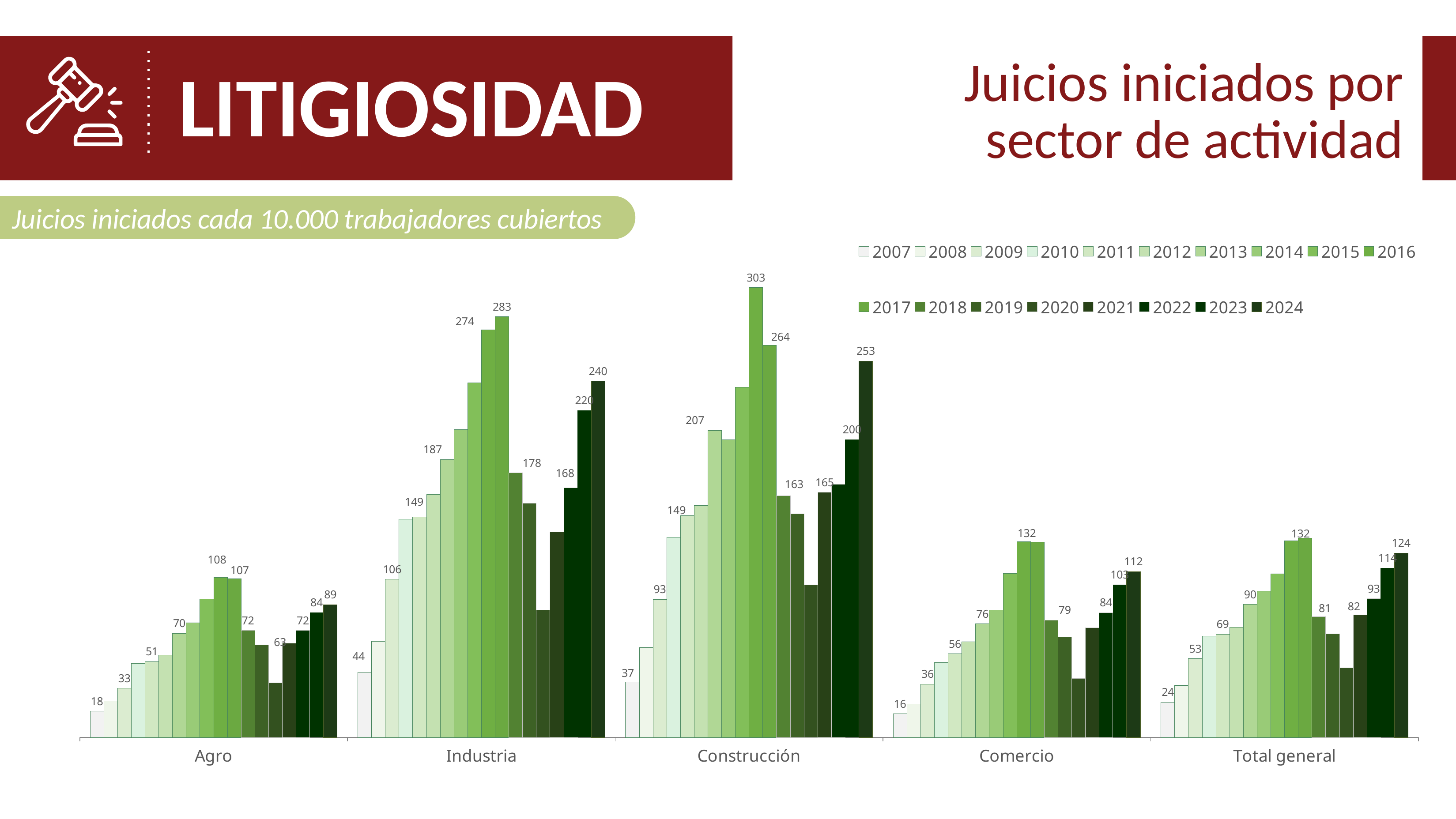
How many series (years) does the legend list? 18 What kind of chart is shown on the slide? bar chart What is the highest data label shown anywhere on the chart, and in which sector? 303, Construcción What is the value of the 2024 bar for Construcción? 253 What is the value of the 2024 bar for Industria? 240 What is the value of the 2007 bar for Agro? 18 What is the difference between the 2024 and 2007 values for Industria? 196 What is the value of the 2007 bar for Comercio? 16 Which is larger, the 2024 value for Comercio or the 2024 value for Total general? Total general How many sector categories are shown on the x axis? 5 Which sector has the lowest 2007 value? Comercio Which sector has the highest 2024 value? Construcción